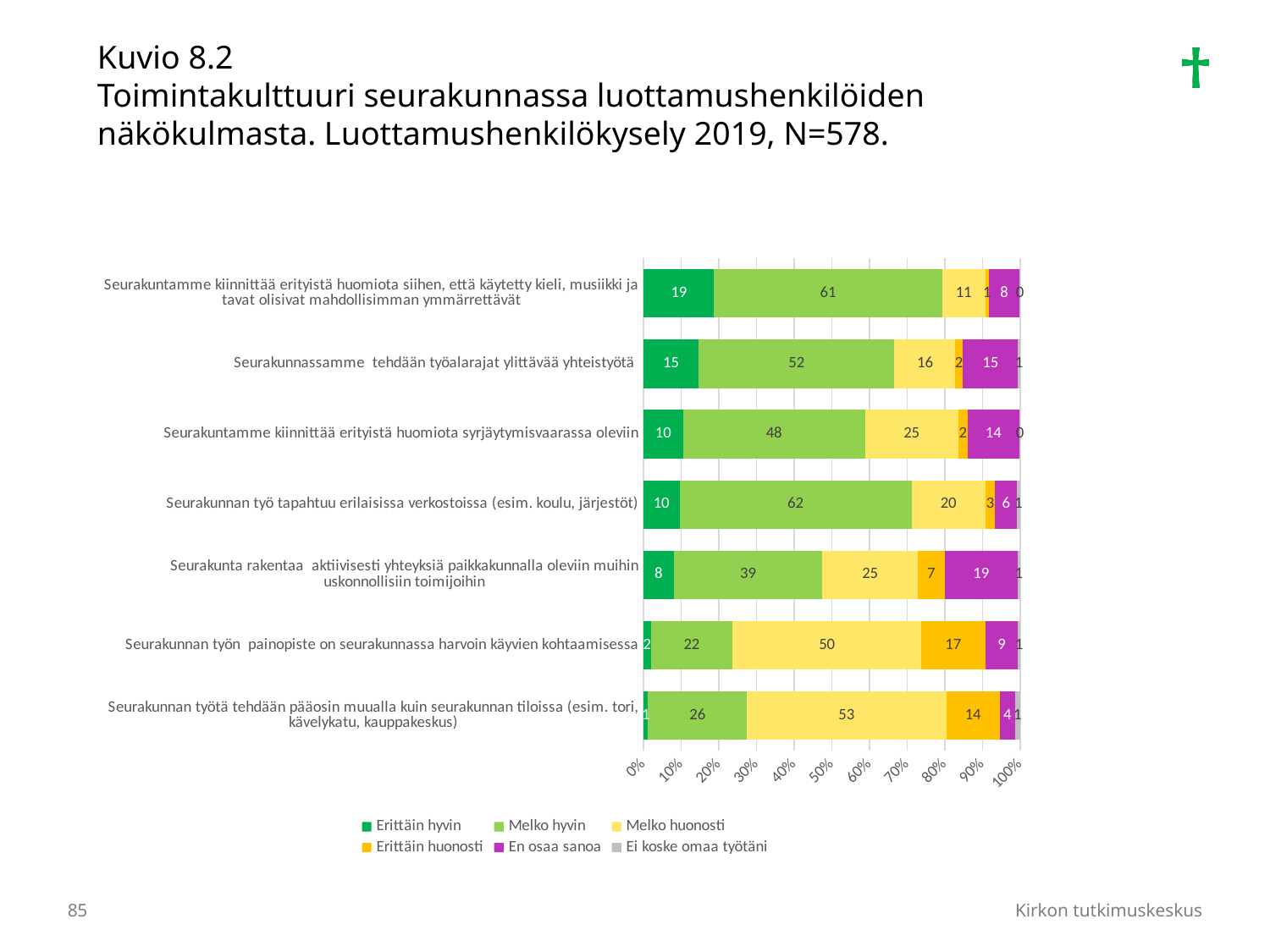
How many series does the legend list? 6 Which statement has the highest 'Erittäin hyvin' value? Seurakuntamme kiinnittää erityistä huomiota siihen, että käytetty kieli, musiikki ja tavat olisivat mahdollisimman ymmärrettävät What is the difference between the 'Melko hyvin' values for 'Seurakunnan työ tapahtuu erilaisissa verkostoissa (esim. koulu, järjestöt)' and 'Seurakunta rakentaa aktiivisesti yhteyksiä paikkakunnalla oleviin muihin uskonnollisiin toimijoihin'? 23 What is the 'Melko huonosti' value for 'Seurakunnan työtä tehdään pääosin muualla kuin seurakunnan tiloissa (esim. tori, kävelykatu, kauppakeskus)'? 53 How many statements (categories) are plotted in the chart? 7 What is the 'En osaa sanoa' value for 'Seurakunta rakentaa aktiivisesti yhteyksiä paikkakunnalla oleviin muihin uskonnollisiin toimijoihin'? 19 Which is larger: the 'Erittäin huonosti' value for 'Seurakunnan työn painopiste on seurakunnassa harvoin käyvien kohtaamisessa' or for 'Seurakunnan työtä tehdään pääosin muualla kuin seurakunnan tiloissa (esim. tori, kävelykatu, kauppakeskus)'? Seurakunnan työn painopiste on seurakunnassa harvoin käyvien kohtaamisessa Which legend entry is shown in dark green? Erittäin hyvin What is the 'Melko hyvin' value for 'Seurakunnan työ tapahtuu erilaisissa verkostoissa (esim. koulu, järjestöt)'? 62 What is the 'Erittäin hyvin' value for 'Seurakunnassamme tehdään työalarajat ylittävää yhteistyötä'? 15 Which statement has the lowest 'Melko hyvin' value? Seurakunnan työn painopiste on seurakunnassa harvoin käyvien kohtaamisessa What type of chart is shown on the slide? Stacked bar chart